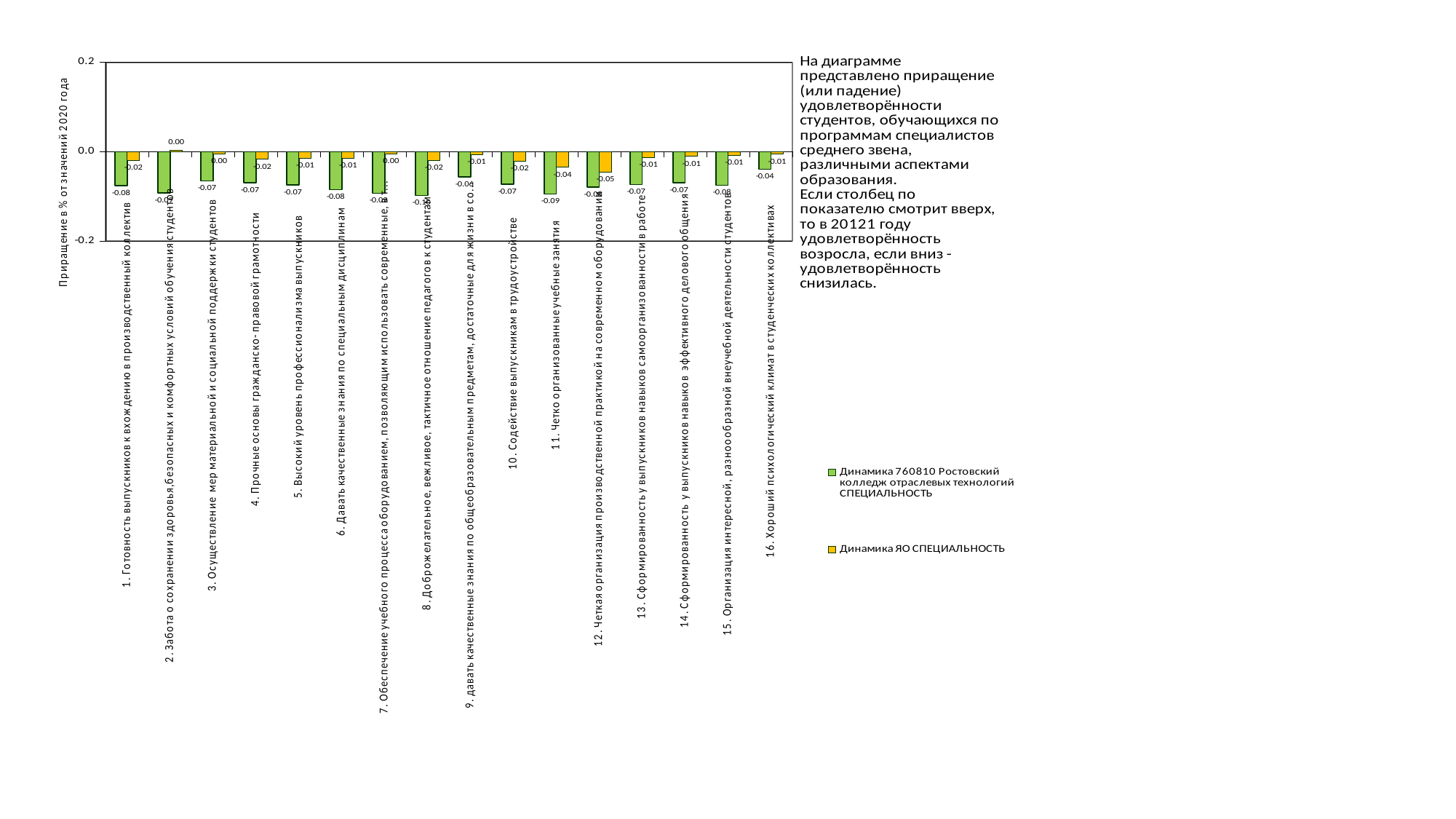
For category '11. Четко организованные учебные занятия', what is the difference between the 'Динамика ЯО СПЕЦИАЛЬНОСТЬ' value and the 'Динамика 760810 Ростовский колледж отраслевых технологий СПЕЦИАЛЬНОСТЬ' value? 0.05 What kind of chart is shown on the slide? bar chart What is the value of the series 'Динамика 760810 Ростовский колледж отраслевых технологий СПЕЦИАЛЬНОСТЬ' for category '16. Хороший психологический климат в студенческих коллективах'? -0.04 For the series 'Динамика 760810 Ростовский колледж отраслевых технологий СПЕЦИАЛЬНОСТЬ', which is larger: the value for category 9 or the value for category '10. Содействие выпускникам в трудоустройстве'? category 9 What is the title of the vertical axis? Приращение в % от значений 2020 года How many categories are plotted along the x axis? 16 What is the value of the series 'Динамика ЯО СПЕЦИАЛЬНОСТЬ' for category '12. Четкая организация производственной практикой на современном оборудовании'? -0.05 Which category has the lowest value for the series 'Динамика ЯО СПЕЦИАЛЬНОСТЬ'? 12. Четкая организация производственной практикой на современном оборудовании Which category has the lowest value for the series 'Динамика 760810 Ростовский колледж отраслевых технологий СПЕЦИАЛЬНОСТЬ'? 8. Доброжелательное, вежливое, тактичное отношение педагогов к студентам What is the value of the series 'Динамика 760810 Ростовский колледж отраслевых технологий СПЕЦИАЛЬНОСТЬ' for category '11. Четко организованные учебные занятия'? -0.09 How many series does the legend list? 2 What is the value of the series 'Динамика ЯО СПЕЦИАЛЬНОСТЬ' for category '1. Готовность выпускников к вхождению в производственный коллектив'? -0.02